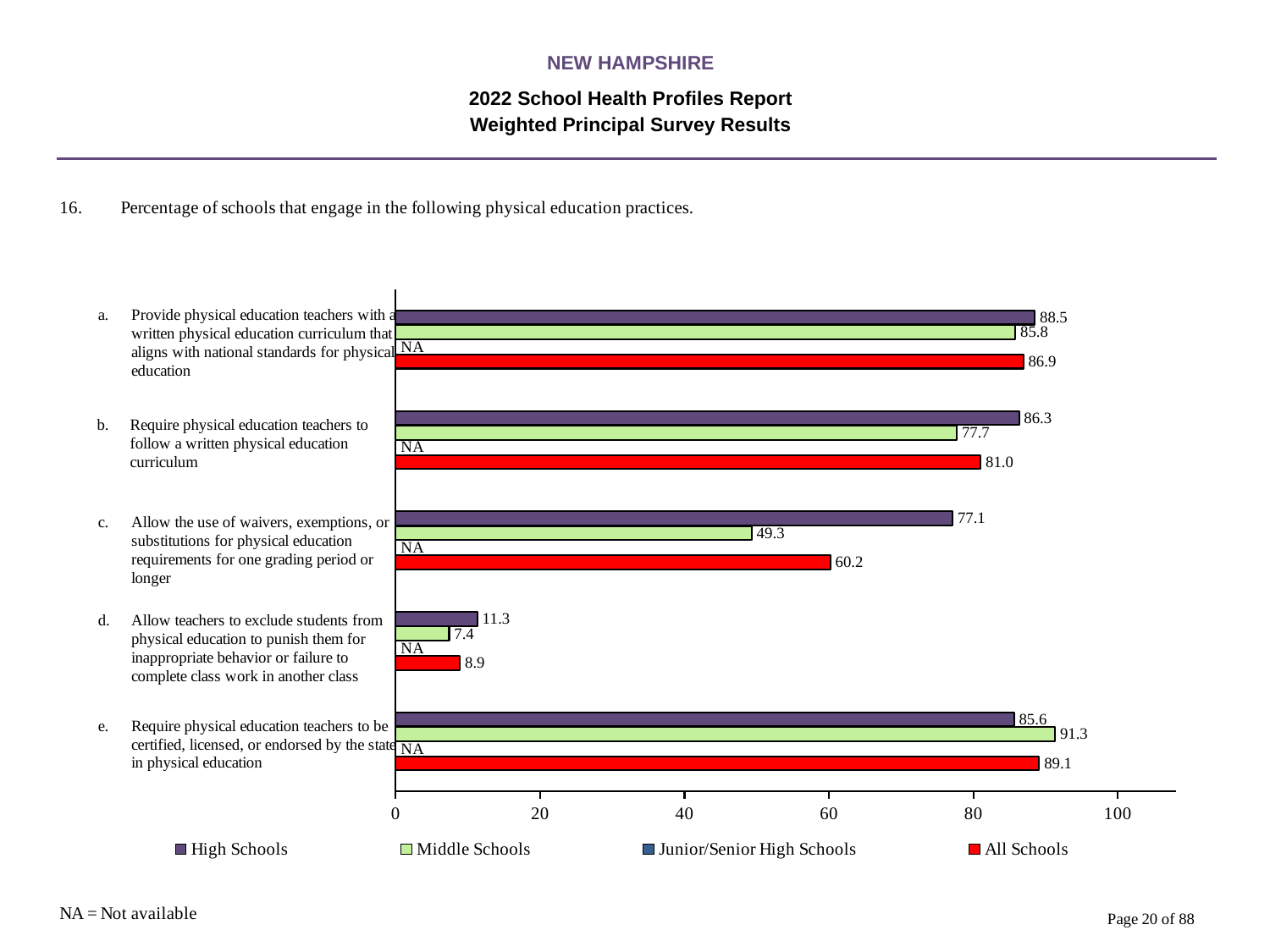
What is shown for Junior/Senior High Schools for practice b (require physical education teachers to follow a written physical education curriculum)? NA For practice e (require physical education teachers to be certified), which is larger: the High Schools value or the Middle Schools value? Middle Schools What is the value for Middle Schools for practice c (allow the use of waivers, exemptions, or substitutions for physical education requirements)? 49.3 What is the value for All Schools for practice e (require physical education teachers to be certified, licensed, or endorsed by the state)? 89.1 Which practice has the lowest value for All Schools? d. Allow teachers to exclude students from physical education to punish them What is the difference between the High Schools and Middle Schools values for practice c (allow the use of waivers, exemptions, or substitutions)? 27.8 What is the value for High Schools for practice a (provide physical education teachers with a written physical education curriculum that aligns with national standards)? 88.5 Is the All Schools value for practice c (allow the use of waivers, exemptions, or substitutions) greater or less than 80? less How many physical education practices are listed on the chart? 5 What kind of chart is shown on the slide? Bar chart How many series does the legend list? 4 Which practice has the highest value for Middle Schools? e. Require physical education teachers to be certified, licensed, or endorsed by the state